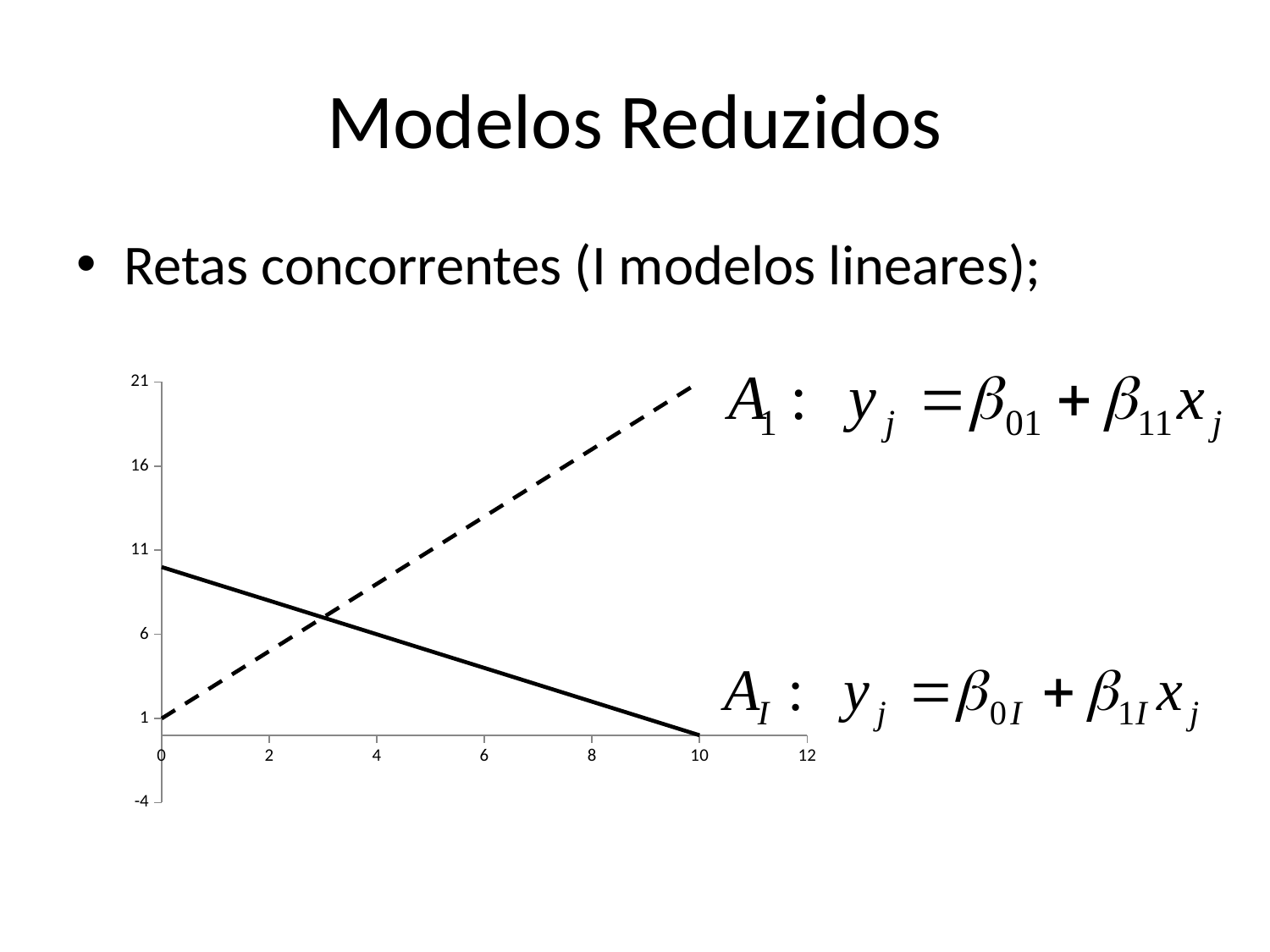
At x = 0, which line has the higher value, the dashed line or the solid line? solid line Is the value of the dashed line at x = 10 greater or less than 16? greater Does the solid line rise or fall as x increases? falls At x = 8, which line has the higher value, the dashed line or the solid line? dashed line Is the value of the solid line at x = 0 greater or less than 6? greater Does the dashed line rise or fall as x increases? rises Is the value of the dashed line at x = 0 greater or less than 6? less How many lines are plotted on the chart? 2 What kind of chart is shown on the slide? line chart What is the highest value shown on the horizontal axis? 12 What is the highest value shown on the vertical axis? 21